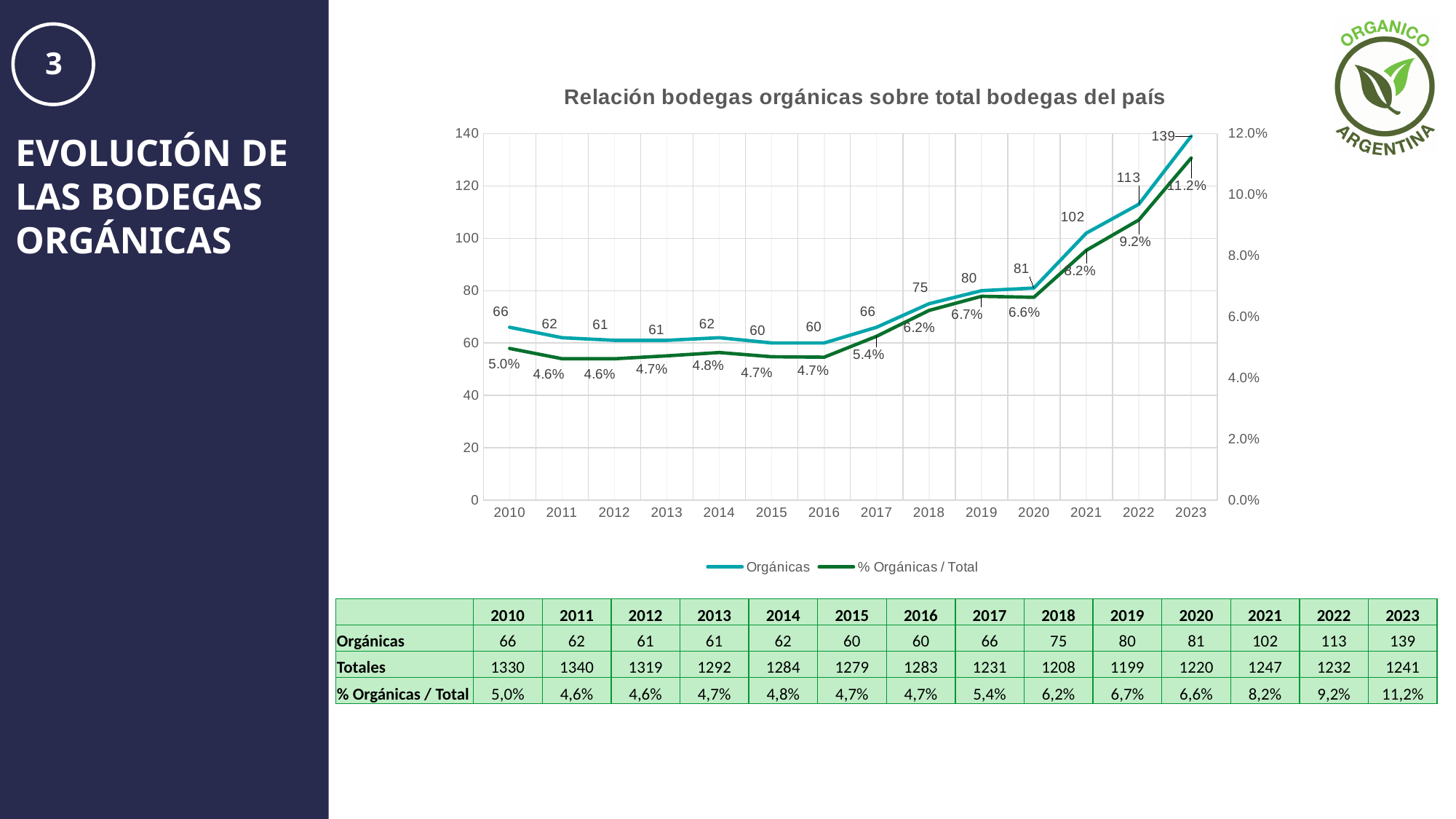
What is the difference between the Orgánicas values for 2023 and 2022? 26 How many years are shown on the x axis of the chart? 14 Is the Orgánicas value for 2021 greater or less than 100? greater Which year has the lowest % Orgánicas / Total value? 2011 and 2012 (4.6%) What is the value of Orgánicas in 2015? 60 Which year has the highest Orgánicas value? 2023 Which is larger, the Orgánicas value for 2018 or for 2020? 2020 What is the value of Orgánicas in 2023? 139 What kind of chart is shown on the slide? line chart How many series does the legend list? 2 What is the % Orgánicas / Total value for 2017? 5.4% What is the title of the chart? Relación bodegas orgánicas sobre total bodegas del país